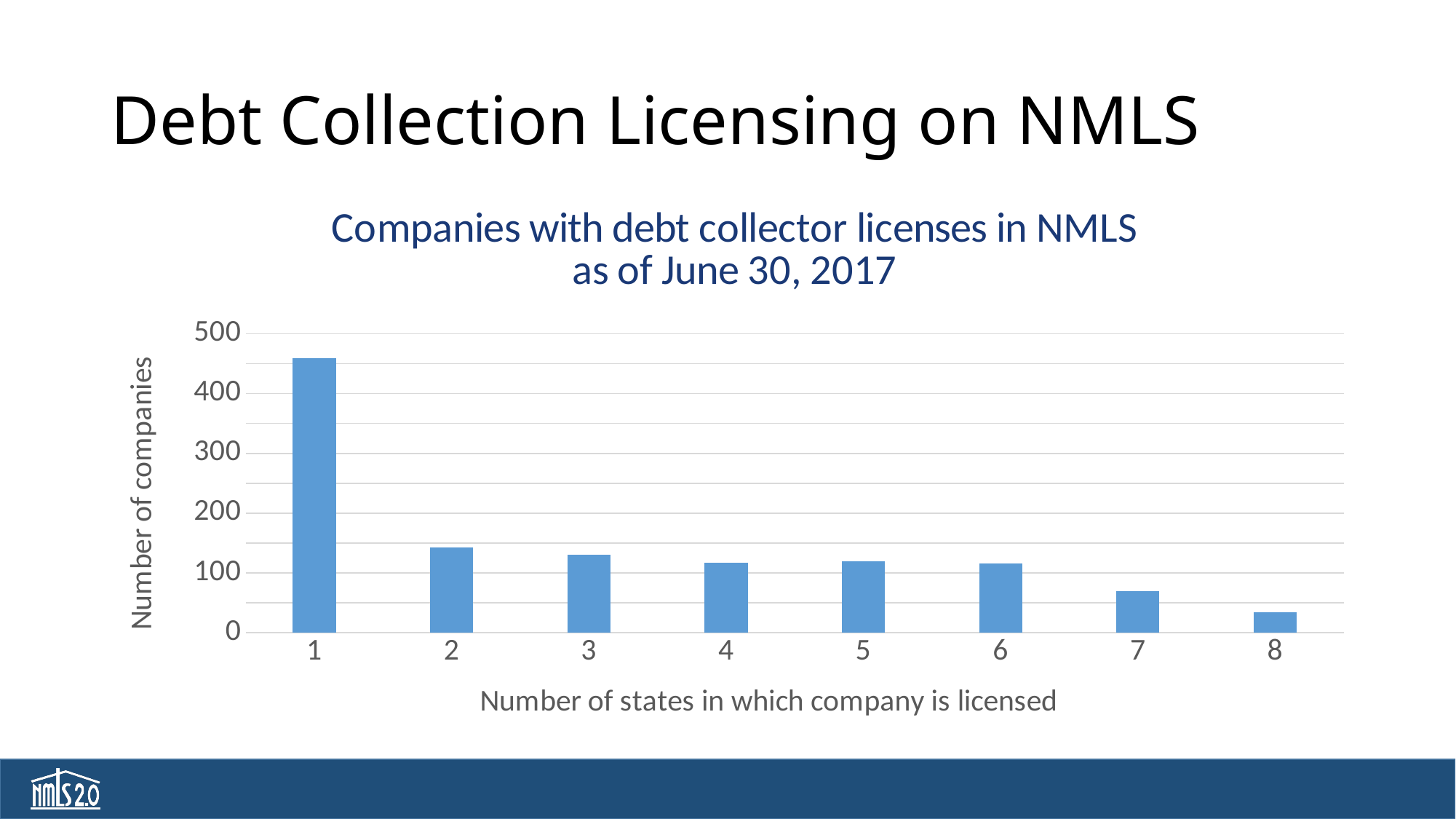
What kind of chart is shown on the slide? Bar chart What is the label of the vertical axis of the chart? Number of companies Is the number of companies licensed in 7 states greater or less than 100? less How many bars (categories) are plotted in the chart? 8 Which number of states has the highest number of companies? 1 Overall, do the values rise or fall as the number of states increases along the x axis? Fall Which has more companies: those licensed in 1 state or those licensed in 2 states? 1 state Is the number of companies licensed in 2 states greater or less than 100? greater Which has more companies: those licensed in 7 states or those licensed in 8 states? 7 states Is the number of companies licensed in 8 states greater or less than 100? less Which number of states has the lowest number of companies? 8